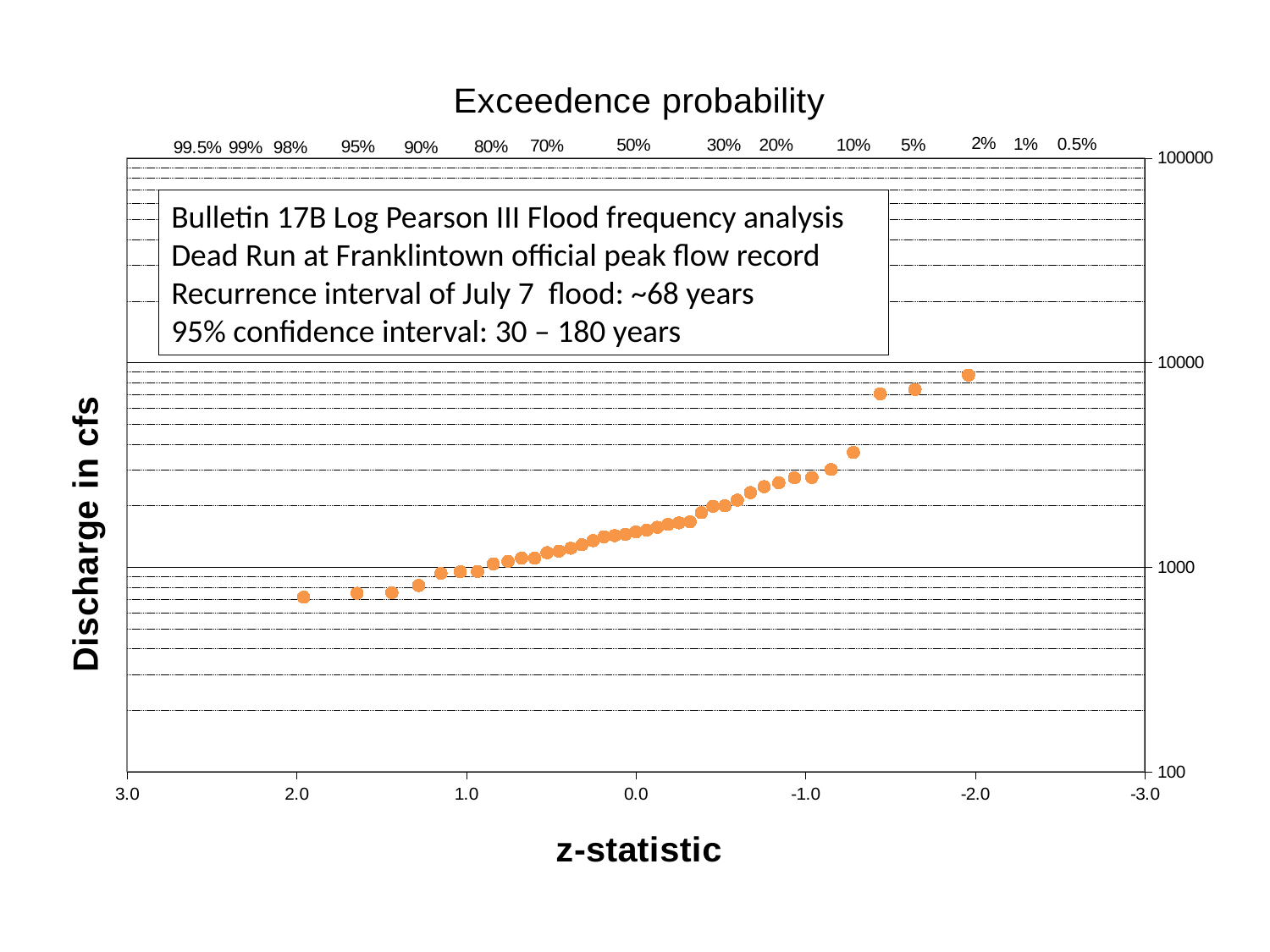
Is the discharge plotted at a z-statistic of 0.0 greater or less than 1000? greater Is the lowest plotted discharge value greater or less than 1000? less Is the discharge plotted at a z-statistic of -1.0 greater or less than 10000? less Do the plotted discharge values rise or fall moving from left to right along the x axis? rise What is the title of the horizontal axis at the bottom of the chart? z-statistic What is the title of the vertical axis? Discharge in cfs What kind of chart is shown on the slide? scatter chart